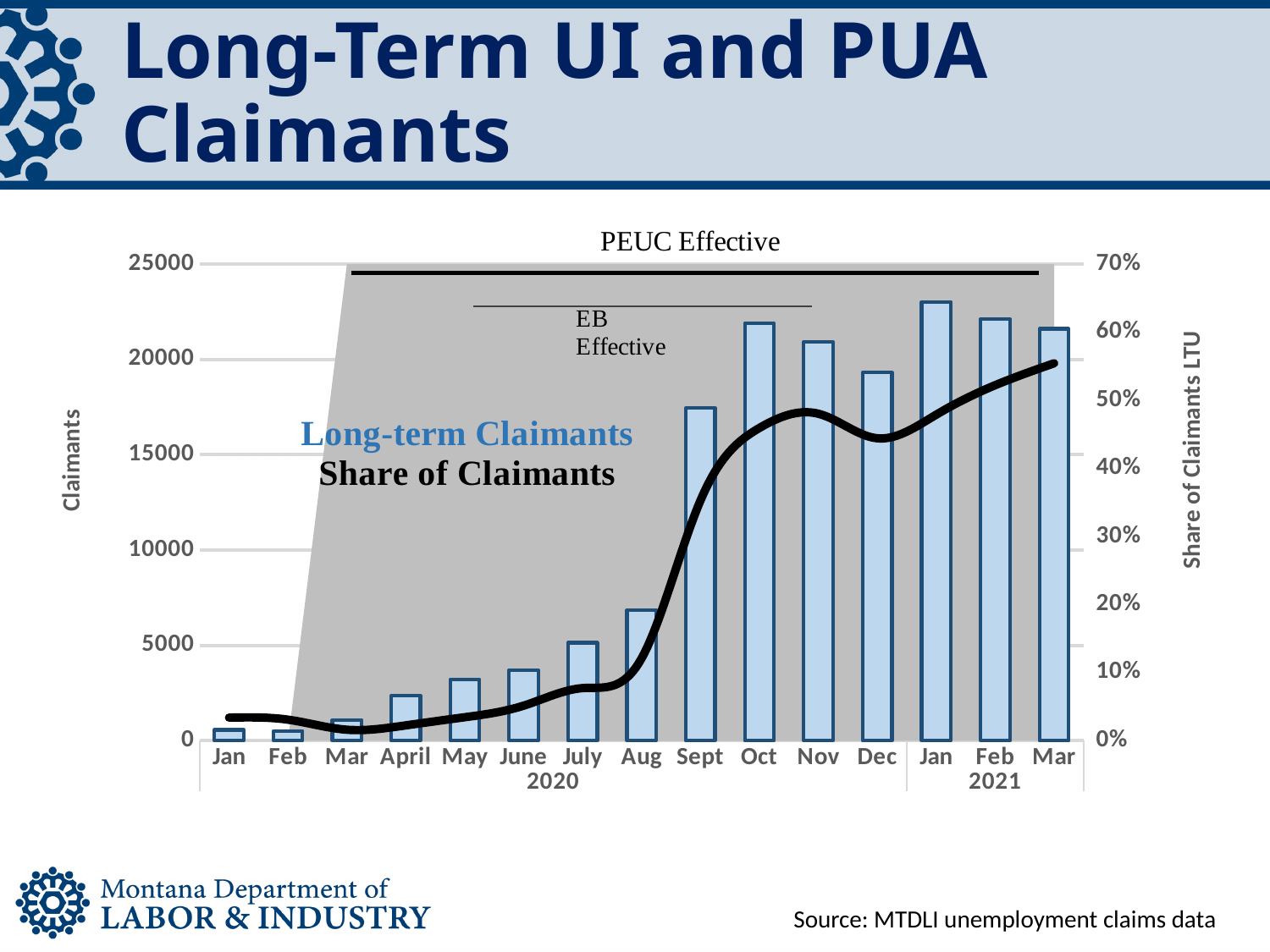
Is the Long-term Claimants value for Oct 2020 greater or less than 20000? greater Is the Long-term Claimants value for Sept 2020 greater or less than 15000? greater Do the Long-term Claimants bars generally rise or fall from Jan 2020 to Mar 2021? rise What kind of chart is shown on the slide? A combined bar and line chart Which month has the larger Long-term Claimants bar, Oct 2020 or Dec 2020? Oct 2020 Is the Share of Claimants value for Aug 2020 greater or less than 20%? less Which month has the tallest Long-term Claimants bar? Jan 2021 What is the title of the right-hand vertical axis? Share of Claimants LTU How many months are plotted along the x axis of the chart? 15